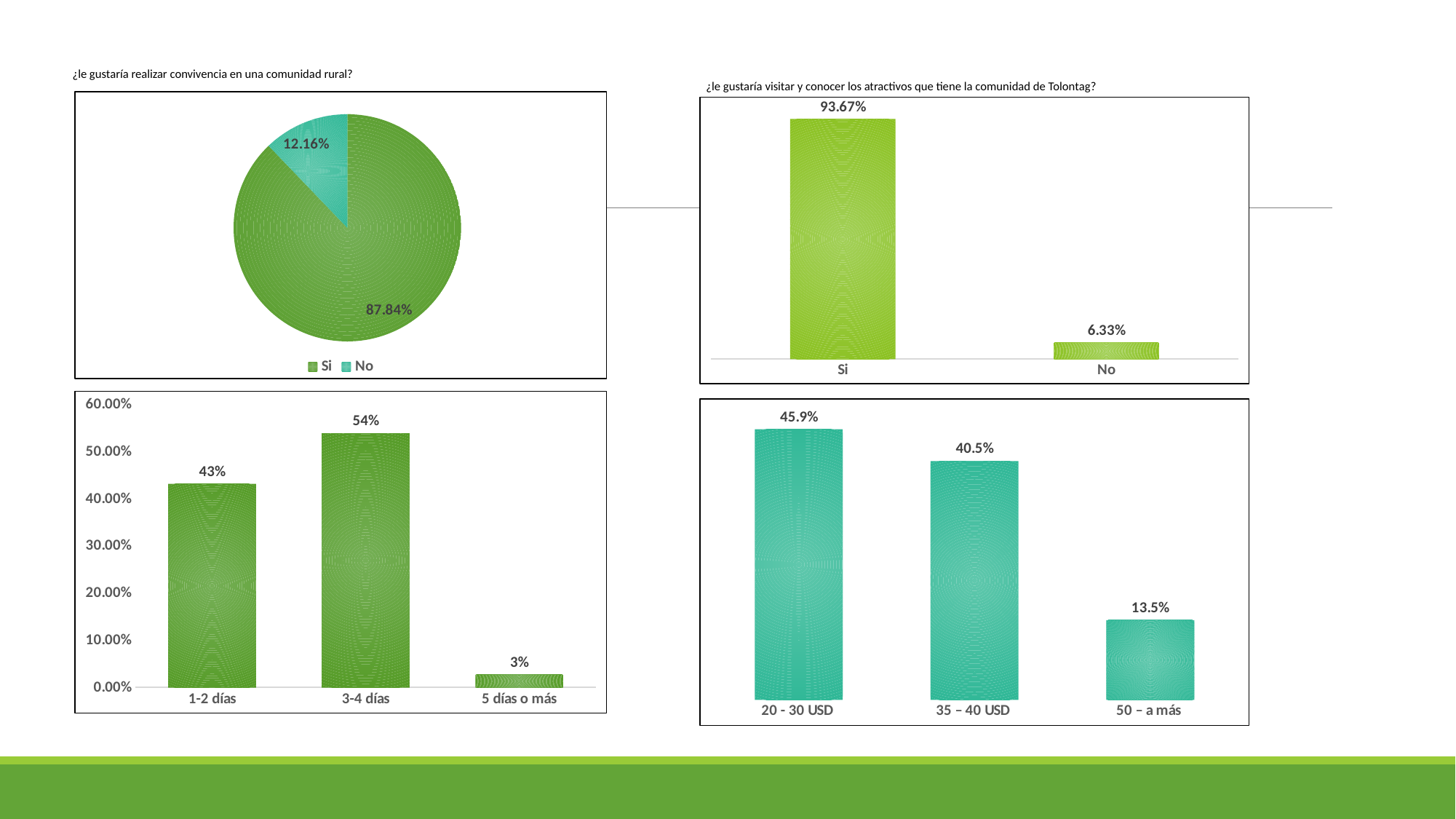
In the bottom-left bar chart, how many categories are shown on the x axis? 3 In the top-right chart (¿le gustaría visitar y conocer los atractivos que tiene la comunidad de Tolontag?), what is the value for 'No'? 6.33% In the bottom-left bar chart, what is the difference between the values for '3-4 días' and '1-2 días'? 11% In the bottom-right bar chart, which category has the highest value? 20 - 30 USD In the bottom-left bar chart, what is the value for '3-4 días'? 54% In the top-left pie chart (¿le gustaría realizar convivencia en una comunidad rural?), what share of the pie is 'No'? 12.16% In the top-left pie chart, how many entries does the legend list? 2 In the top-left pie chart (¿le gustaría realizar convivencia en una comunidad rural?), what share of the pie is 'Si'? 87.84% In the bottom-right bar chart, what is the value for '50 – a más'? 13.5% In the top-right chart (¿le gustaría visitar y conocer los atractivos que tiene la comunidad de Tolontag?), what is the value for 'Si'? 93.67% What kind of chart is the top-right chart about visiting the attractions of Tolontag? Bar chart In the bottom-left bar chart, which category has the lowest value? 5 días o más